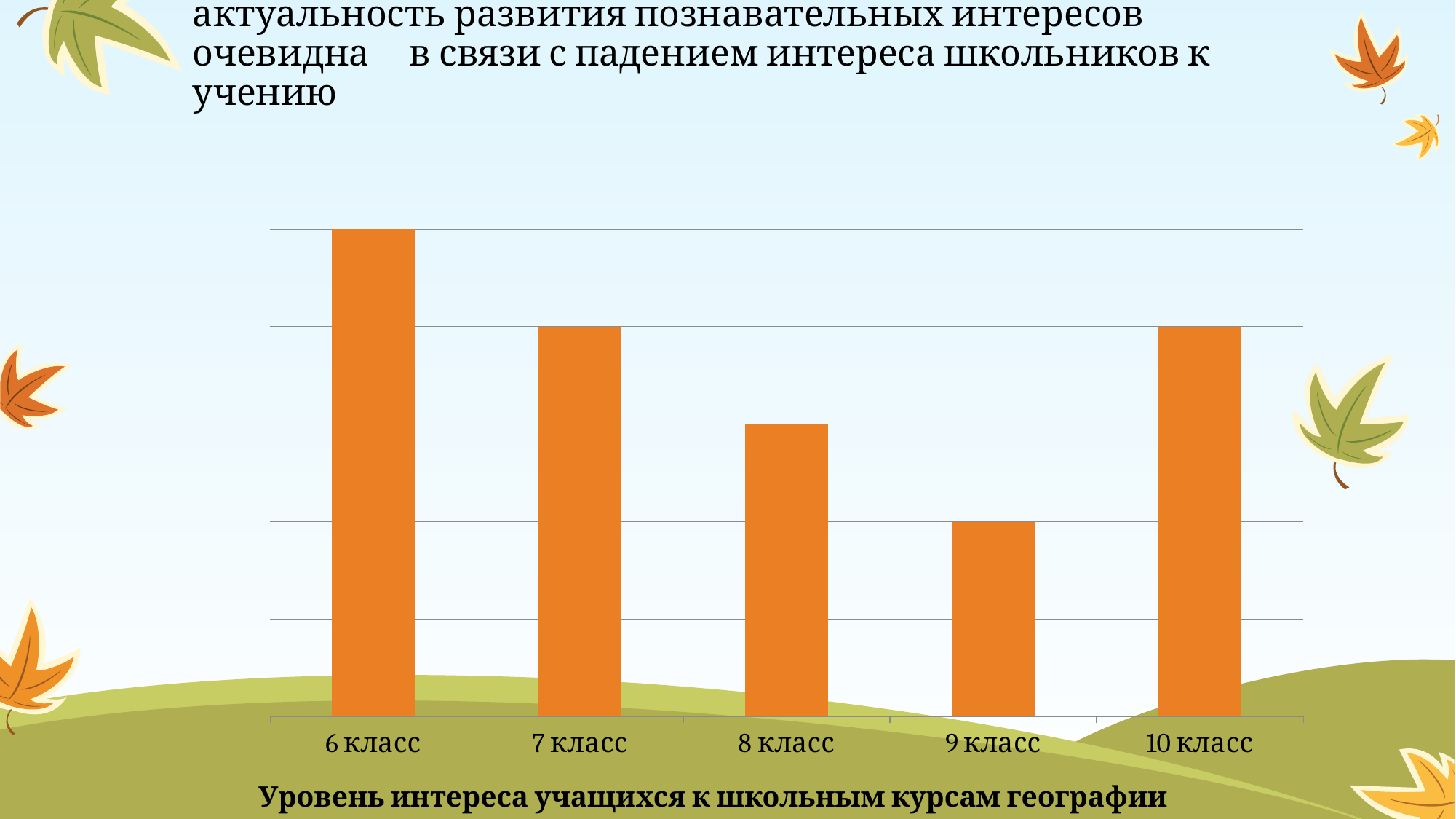
Which class has the highest level of interest in the chart? 6 класс Which bar is taller: 9 класс or 10 класс? 10 класс What is the label of the first category on the x axis? 6 класс Do the values rise or fall from 6 класс to 9 класс? fall What is the title of the chart? Уровень интереса учащихся к школьным курсам географии How many categories (classes) are shown on the x axis of the chart? 5 Which bar is taller: 7 класс or 8 класс? 7 класс Which bar is taller: 8 класс or 9 класс? 8 класс Which class has the lowest level of interest in the chart? 9 класс What colour are the bars in the chart? orange What kind of chart is shown on the slide? bar chart